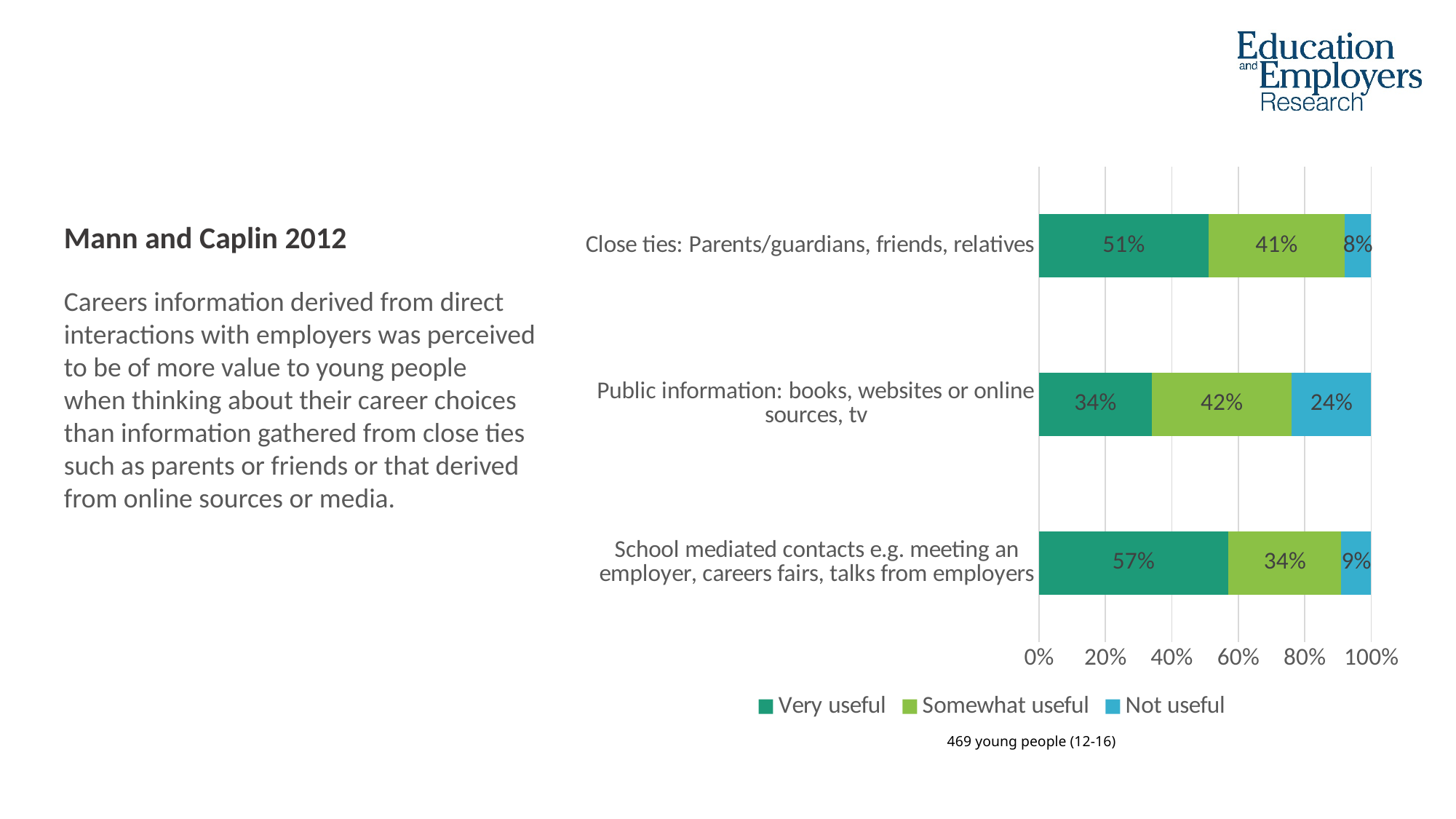
Which has a larger not useful share: public information or school mediated contacts? Public information: books, websites or online sources, tv How many sources of careers information are shown in the chart? 3 What is the total of the stacked bar for close ties (parents/guardians, friends, relatives)? 100% What percentage rated public information (books, websites or online sources, tv) as not useful? 24% Which source of careers information has the highest share rated very useful? School mediated contacts e.g. meeting an employer, careers fairs, talks from employers What kind of chart is shown on the slide? Stacked bar chart How many series does the legend list? 3 What percentage of young people rated close ties (parents/guardians, friends, relatives) as very useful? 51% What percentage rated school mediated contacts as somewhat useful? 34% Is the very useful value for public information greater or less than 40%? less Which source of careers information has the lowest share rated not useful? Close ties: Parents/guardians, friends, relatives What is the difference between the very useful percentages for school mediated contacts and public information? 23 percentage points